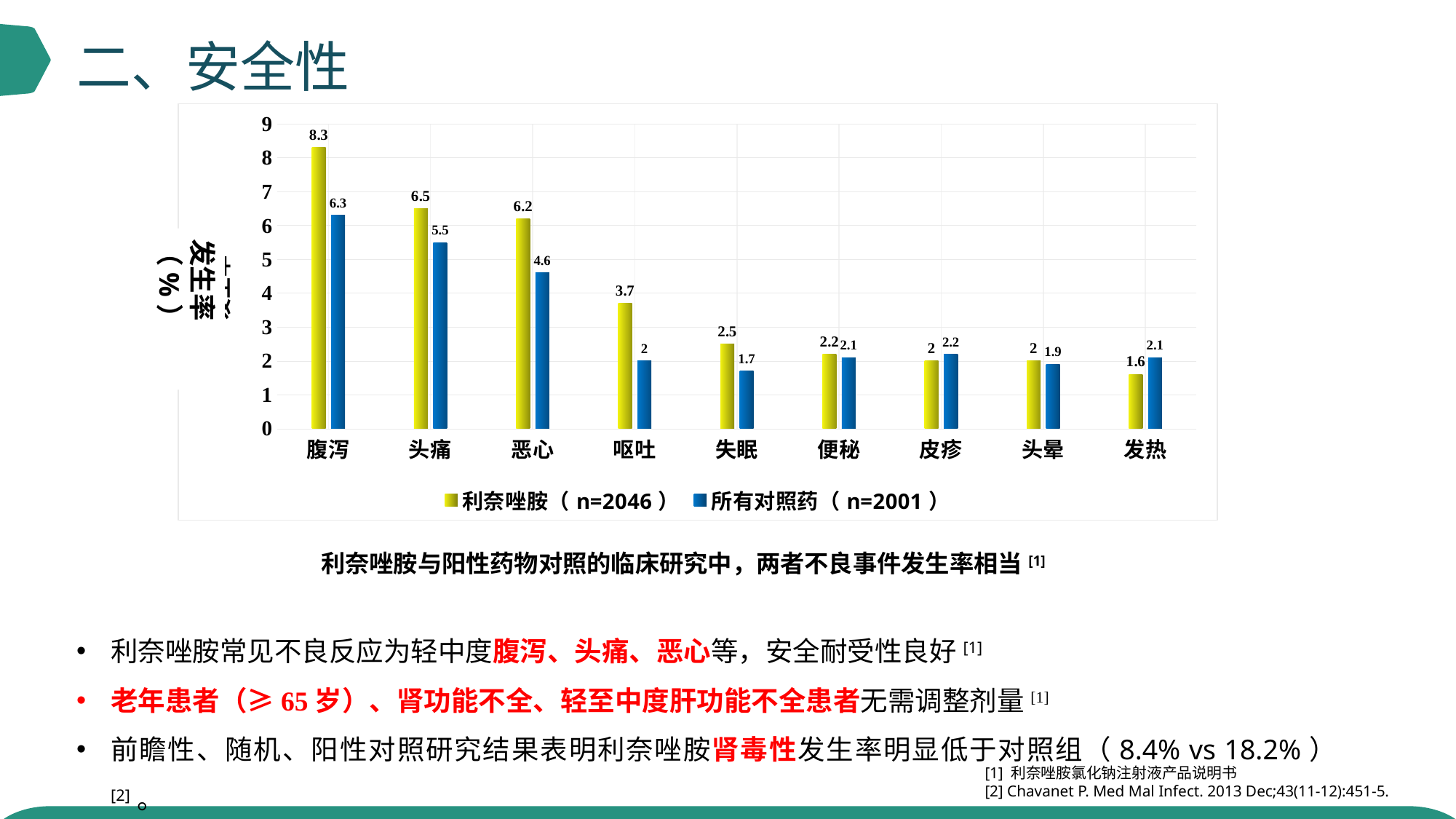
How many categories are shown on the x axis of the chart? 9 For 皮疹, which series has the larger value, 利奈唑胺（n=2046） or 所有对照药（n=2001）? 所有对照药（n=2001） What kind of chart is shown on the slide? bar chart What is the value for 腹泻 in the 利奈唑胺（n=2046） series? 8.3 Which category has the highest value in the 利奈唑胺（n=2046） series? 腹泻 Which category has the lowest value in the 利奈唑胺（n=2046） series? 发热 What is the value for 呕吐 in the 利奈唑胺（n=2046） series? 3.7 Is the value for 失眠 in the 利奈唑胺（n=2046） series greater or less than 3? less What is the value for 恶心 in the 所有对照药（n=2001） series? 4.6 What is the difference between the 利奈唑胺（n=2046） and 所有对照药（n=2001） values for 头痛? 1 How many series does the chart legend list? 2